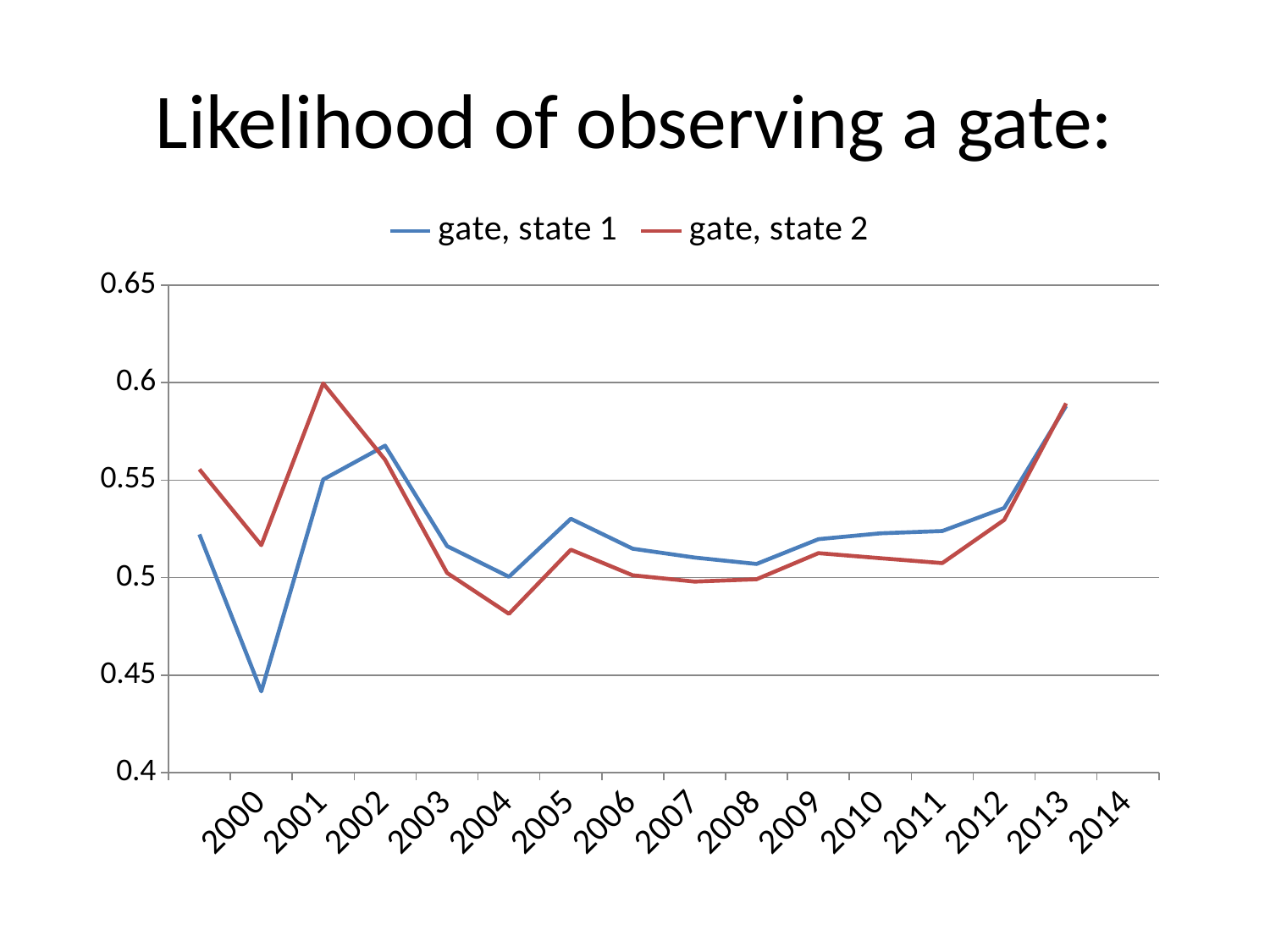
How many series does the legend list? 2 Is the highest value of gate, state 2 greater or less than 0.55? greater Which series reaches the highest point on the chart? gate, state 2 How many years are labelled along the x axis? 15 Which series reaches the lowest point on the chart? gate, state 1 Which series is drawn in red? gate, state 2 At the first year shown, which series has the higher value, gate, state 1 or gate, state 2? gate, state 2 What kind of chart is shown on the slide? line chart Is the lowest value of gate, state 1 greater or less than 0.45? less What is the title of the chart? Likelihood of observing a gate: Over the last three years shown, do the two lines rise or fall? rise Is the lowest value of gate, state 2 greater or less than 0.5? less